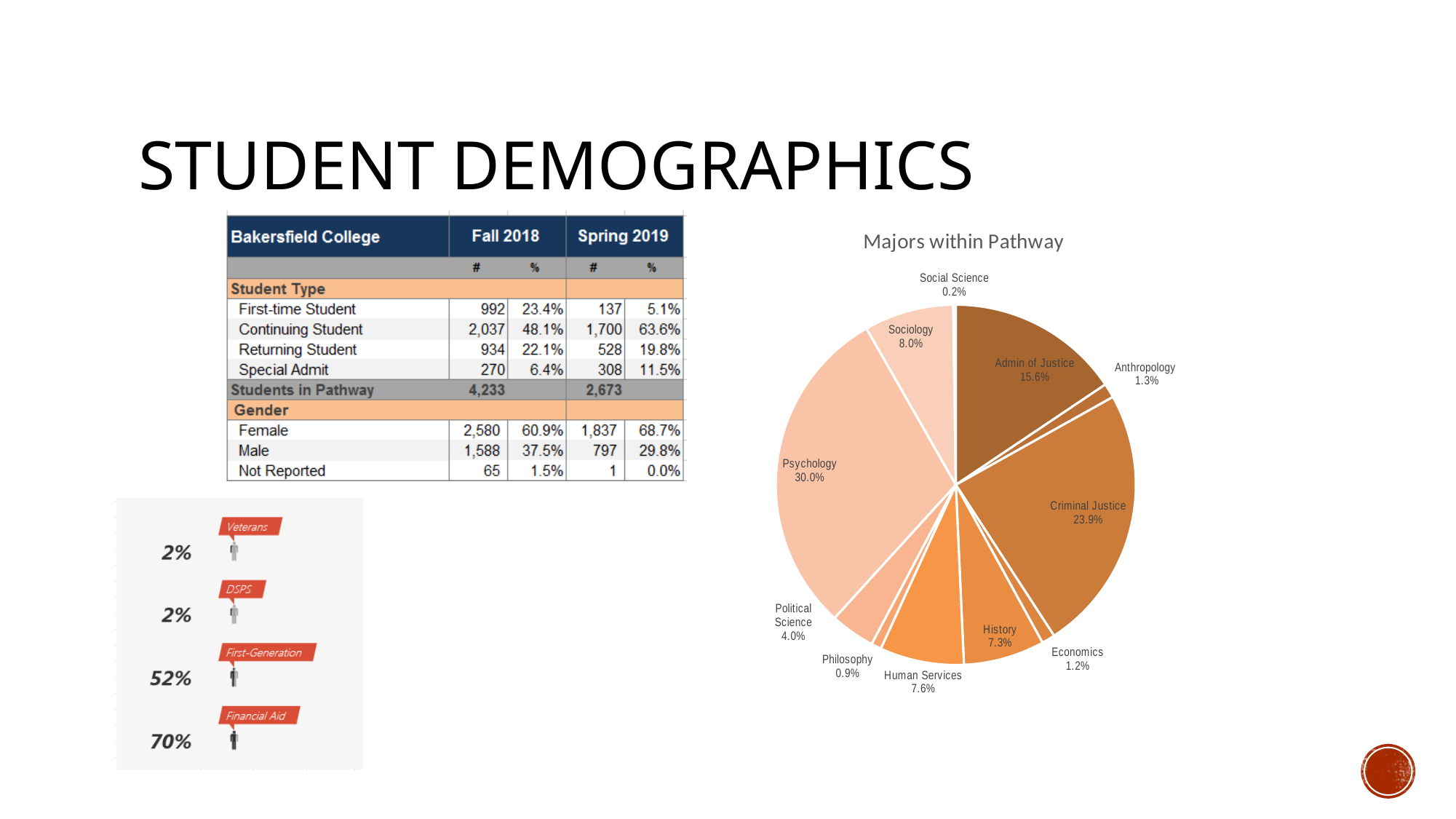
In the 'Majors within Pathway' pie chart, which major has the largest slice? Psychology In the 'Majors within Pathway' pie chart, what share does Psychology have? 30.0% What type of chart is 'Majors within Pathway'? Pie chart In the 'Majors within Pathway' pie chart, which is larger, Admin of Justice or Criminal Justice? Criminal Justice In the 'Majors within Pathway' pie chart, what is the difference between Sociology and History? 0.7 In the 'Majors within Pathway' pie chart, which is larger, Sociology or Political Science? Sociology How many slices does the 'Majors within Pathway' pie chart have? 11 In the 'Majors within Pathway' pie chart, what is the value for Admin of Justice? 15.6% In the 'Majors within Pathway' pie chart, how many percentage points larger is Psychology than Criminal Justice? 6.1 In the 'Majors within Pathway' pie chart, what share does Human Services have? 7.6% In the 'Majors within Pathway' pie chart, what percentage is shown for Criminal Justice? 23.9% In the 'Majors within Pathway' pie chart, which major has the smallest slice? Social Science